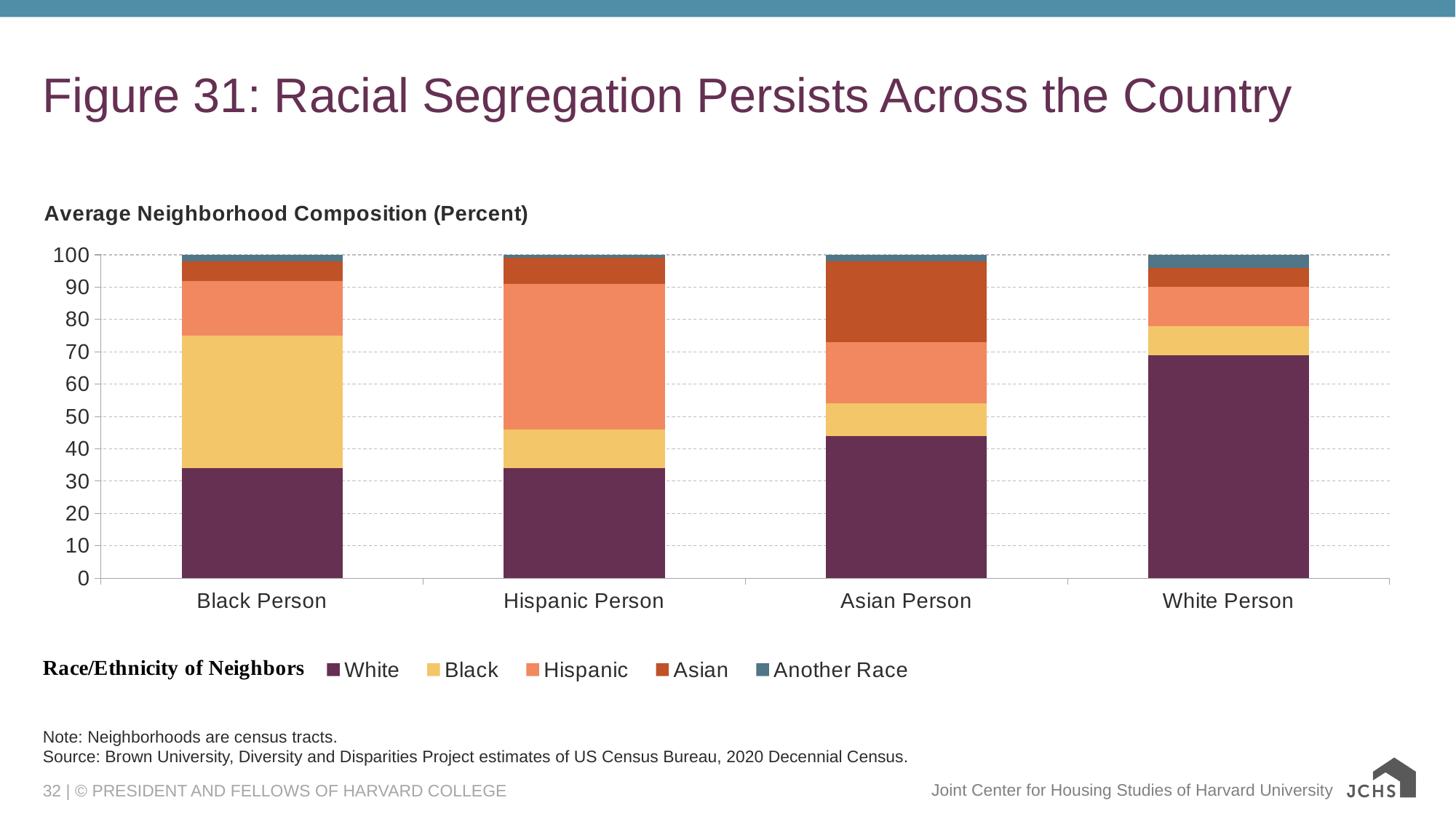
How many series does the chart's legend list? 5 Which category has the largest Asian share of neighbors? Asian Person What is the title of the chart's legend? Race/Ethnicity of Neighbors Which category has the largest White share of neighbors? White Person Is the White share of neighbors larger for Asian Person or for Black Person? Asian Person Is the White share of neighbors for White Person greater or less than 60? greater How many categories are shown on the x axis of the chart? 4 What kind of chart is shown on the slide? Stacked bar chart Which category has the largest Hispanic share of neighbors? Hispanic Person Is the Black share of neighbors for Black Person greater or less than 30? greater Is the White share of neighbors for Asian Person greater or less than 50? less